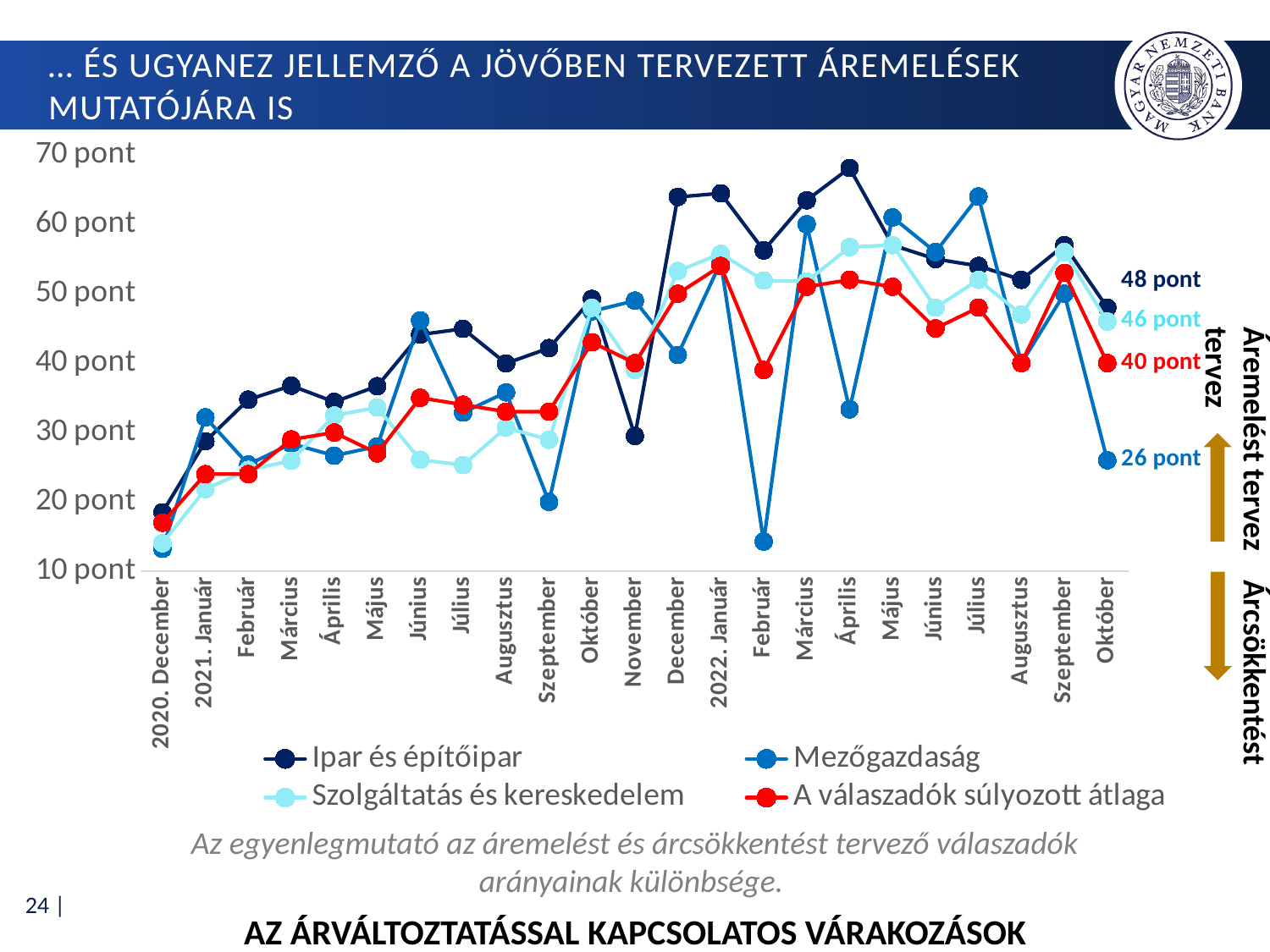
Is the value for Ipar és építőipar in 2022. Április greater or less than 60 pont? greater What kind of chart is shown on the slide? Line chart What is the value for A válaszadók súlyozott átlaga in 2022. Október? 40 pont Which series has the highest value in 2022. Október? Ipar és építőipar What is the difference between the 2022. Október values of Ipar és építőipar and Mezőgazdaság? 22 pont What is the value for Szolgáltatás és kereskedelem in 2022. Október? 46 pont What is the value for Mezőgazdaság in 2022. Október? 26 pont Which series has the lowest value in 2022. Október? Mezőgazdaság Is the value for Mezőgazdaság in 2022. Február greater or less than 20 pont? less How many series does the legend list? 4 How many months are shown on the x axis? 23 What is the value for Ipar és építőipar in 2022. Október? 48 pont